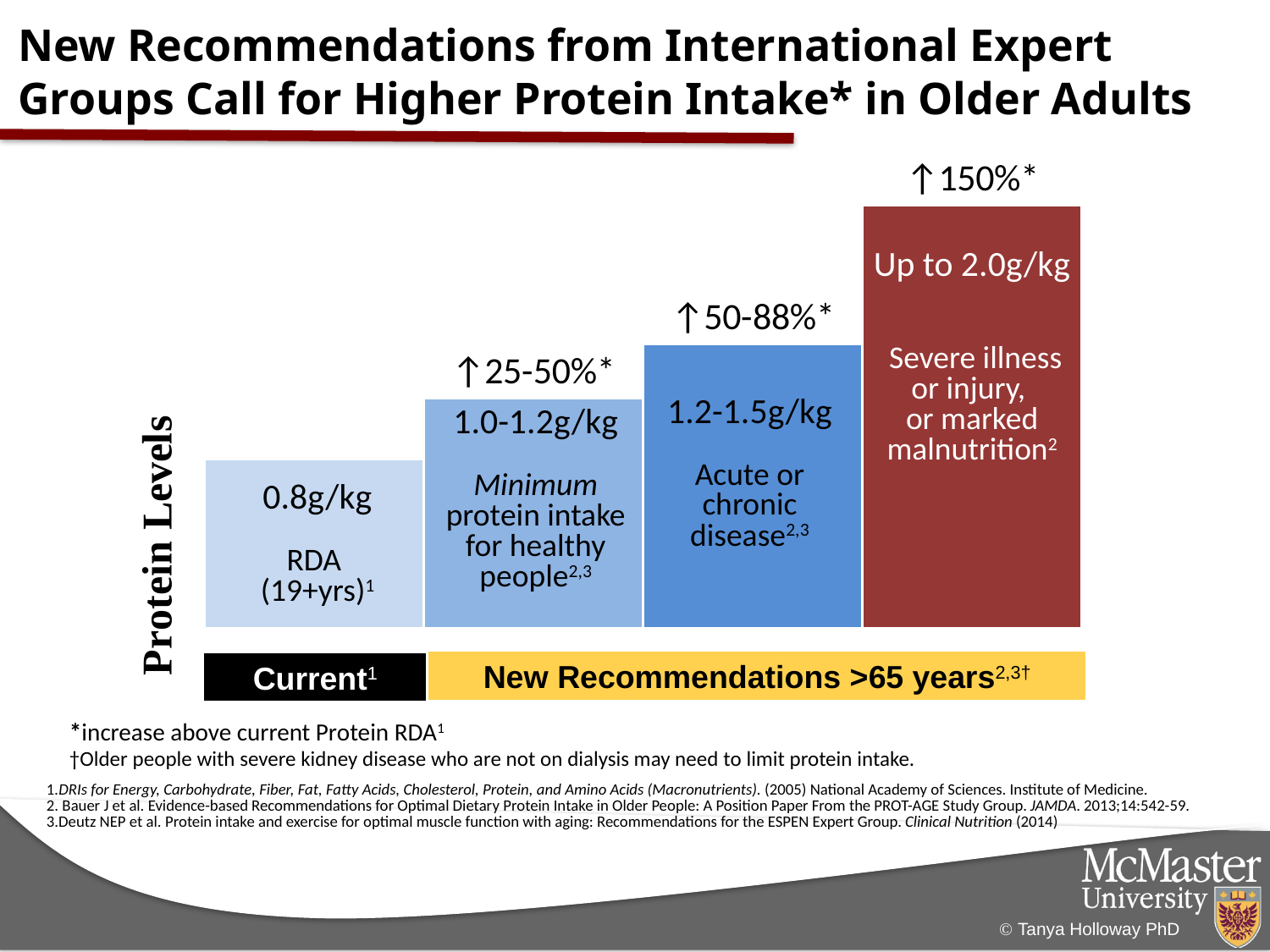
What percentage increase above the current protein RDA is shown above the severe illness or injury bar? ↑150% What percentage increase above the current protein RDA is shown above the acute or chronic disease bar? ↑50-88% How many bars are shown in the chart? 4 Do the protein levels rise or fall from left to right across the bars? Rise What protein level is shown for the minimum protein intake for healthy people? 1.0-1.2g/kg What percentage increase above the current protein RDA is shown above the minimum protein intake for healthy people bar? ↑25-50% What protein level is shown for severe illness or injury, or marked malnutrition? Up to 2.0g/kg What protein level is shown for acute or chronic disease? 1.2-1.5g/kg What is the label on the y axis of the chart? Protein Levels Which category has the highest protein level? Severe illness or injury, or marked malnutrition Which category has the lowest protein level? RDA (19+yrs) What protein level is shown for the RDA (19+yrs) bar? 0.8g/kg